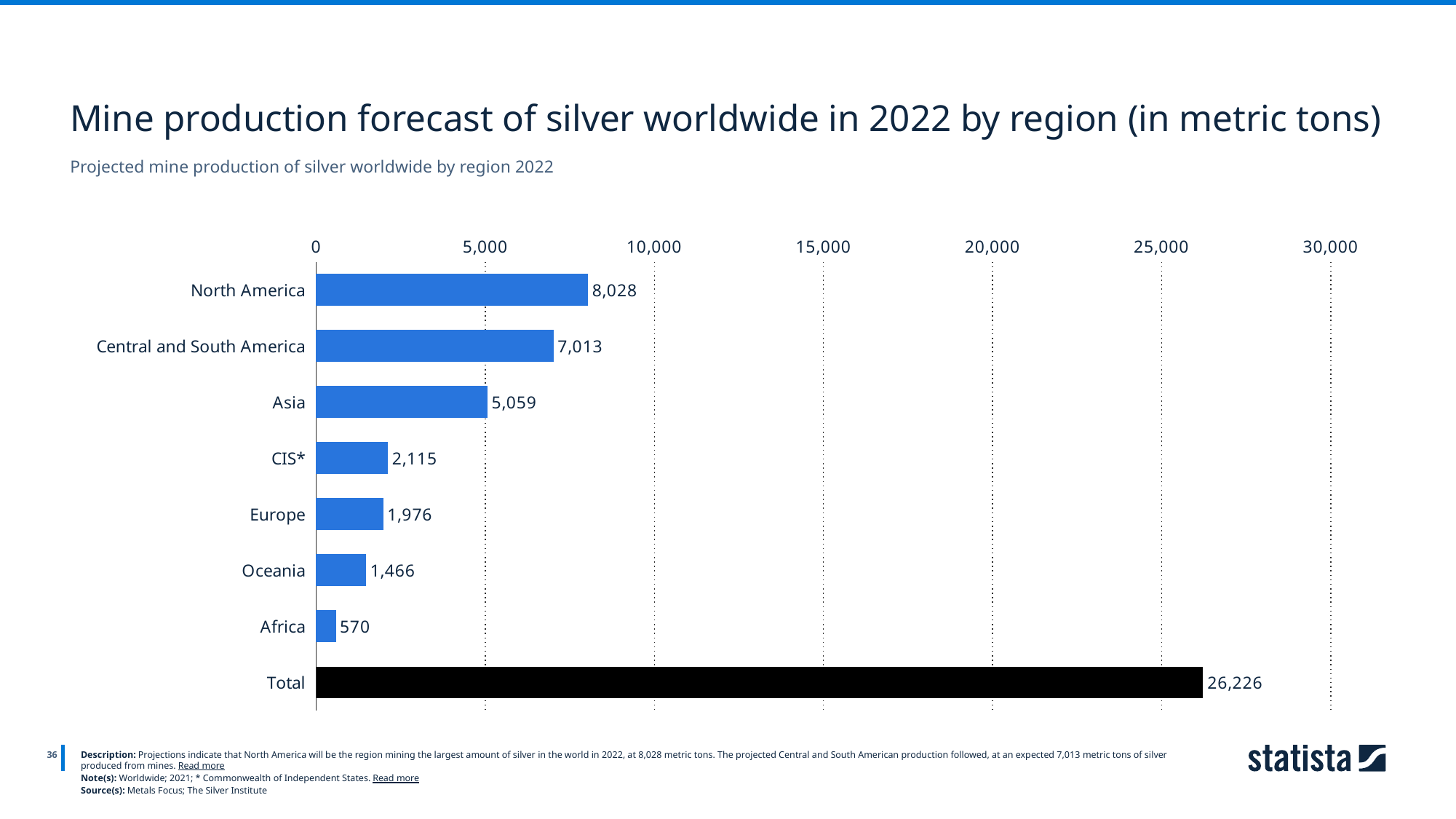
Excluding the Total bar, which region has the highest projected silver mine production? North America What is the difference between the values for CIS* and Europe? 139 What is the difference between the values for North America and Central and South America? 1,015 What type of chart is shown on the slide? Bar chart What is the value shown for Oceania? 1,466 What is the projected silver mine production for Asia? 5,059 Which region has the lowest projected silver mine production? Africa Which has a larger value, Asia or Central and South America? Central and South America What is the value shown for the Total bar? 26,226 How many bars are shown in the chart, including the Total bar? 8 What is the projected silver mine production for North America in 2022? 8,028 Is the value for Asia greater or less than 5,000? greater